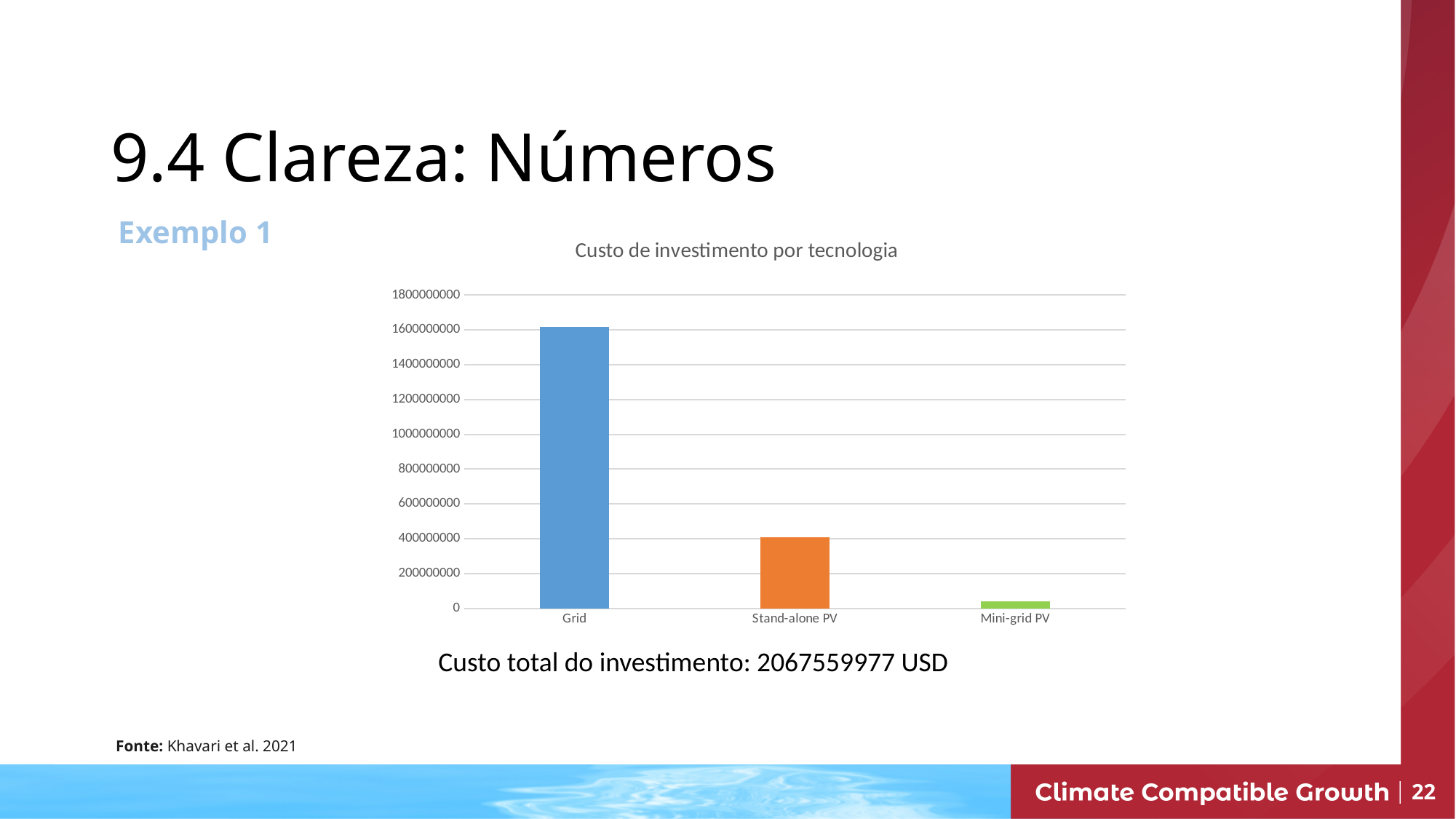
How many technology categories are plotted in the chart? 3 Which has a larger investment cost, Stand-alone PV or Mini-grid PV? Stand-alone PV Is the value for Stand-alone PV greater or less than 600000000? less Which technology has the highest investment cost in the chart? Grid Is the value for Mini-grid PV greater or less than 200000000? less Which has a larger investment cost, Grid or Stand-alone PV? Grid Which technology has the lowest investment cost in the chart? Mini-grid PV Is the value for Grid greater or less than 1400000000? greater What is the title of the chart? Custo de investimento por tecnologia What kind of chart is shown on the slide? bar chart Do the bar values rise or fall from left to right across the categories? fall